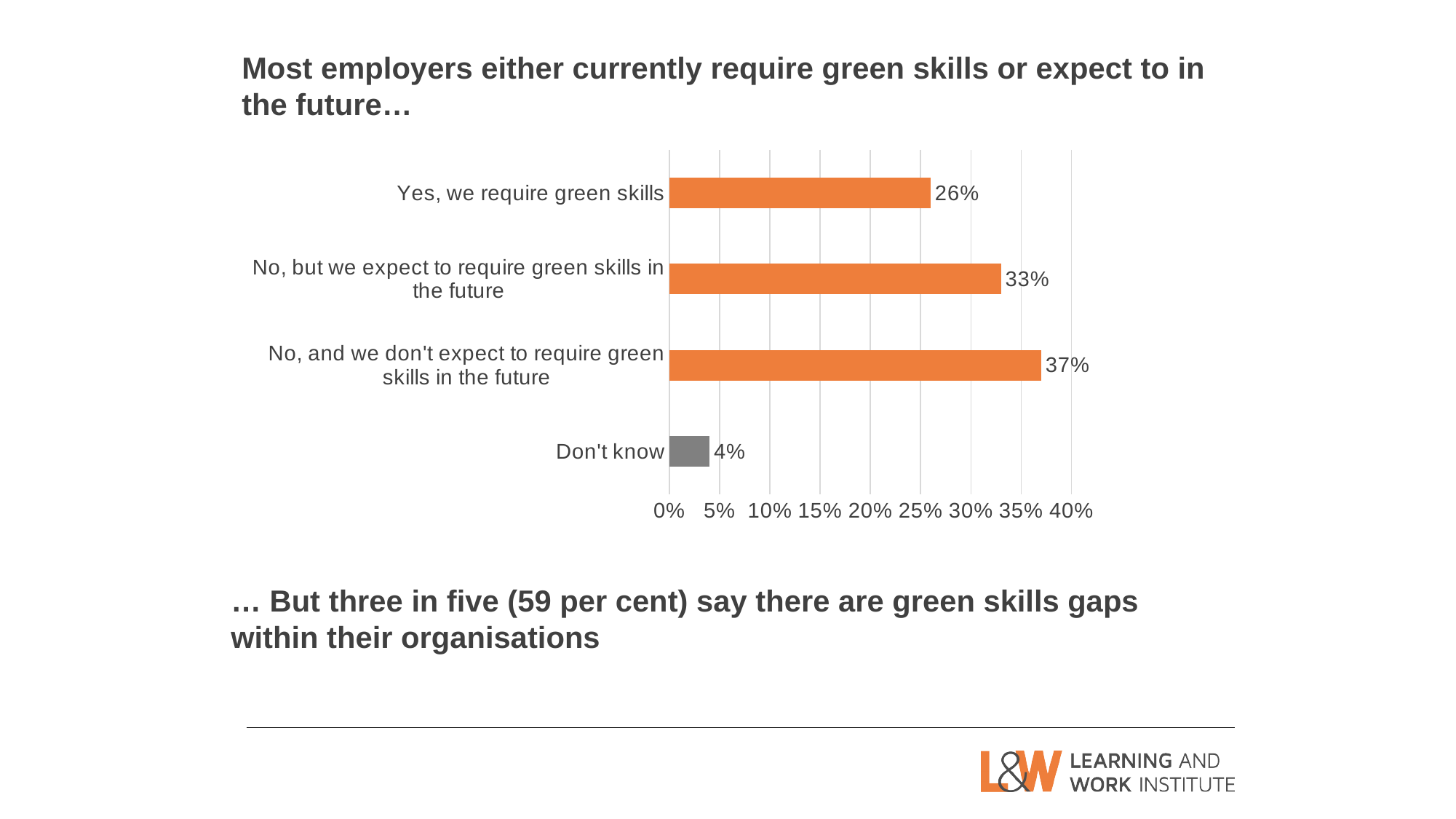
What is the highest value shown on the x axis? 40% Which category has the lowest value? Don't know How many categories are shown in the chart? 4 What percentage of employers say "Yes, we require green skills"? 26% Which category has the highest value? No, and we don't expect to require green skills in the future What kind of chart is shown on the slide? Bar chart Which bar is coloured grey rather than orange? Don't know Which is larger: "No, but we expect to require green skills in the future" or "Yes, we require green skills"? No, but we expect to require green skills in the future What is the value for "No, and we don't expect to require green skills in the future"? 37% What percentage of employers answered "Don't know"? 4% What is the value for "No, but we expect to require green skills in the future"? 33% What is the difference between "No, and we don't expect to require green skills in the future" and "Yes, we require green skills"? 11%